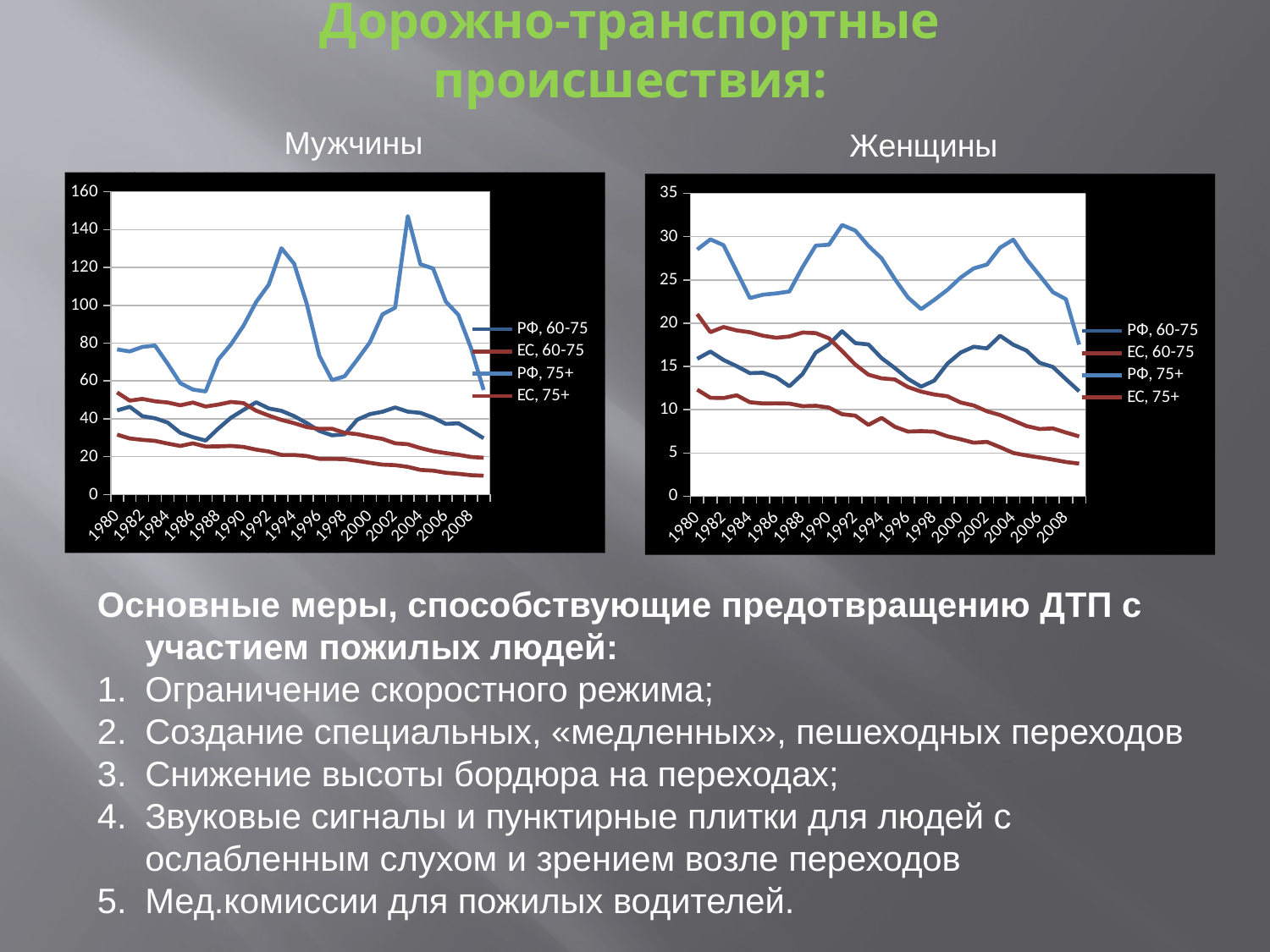
What is the title of the chart on the right? Женщины In the "Женщины" chart, which series is higher in 2008: "РФ, 75+" or "ЕС, 75+"? РФ, 75+ In the "Женщины" chart, is the value for "ЕС, 75+" in 2008 greater or less than 5? greater In the "Женщины" chart, does the "ЕС, 60-75" series rise or fall over the period shown? fall What is the first year shown on the x axis of the "Мужчины" chart? 1980 In the "Мужчины" chart, which series reaches the highest value overall? РФ, 75+ What kind of chart is the "Мужчины" chart on the left? line chart How many series does the legend of the "Женщины" chart list? 4 In the "Мужчины" chart, does the "ЕС, 60-75" series rise or fall from 1980 to 2008? fall In the "Мужчины" chart, is the peak value of the "РФ, 75+" series around 2003 greater or less than 140? greater